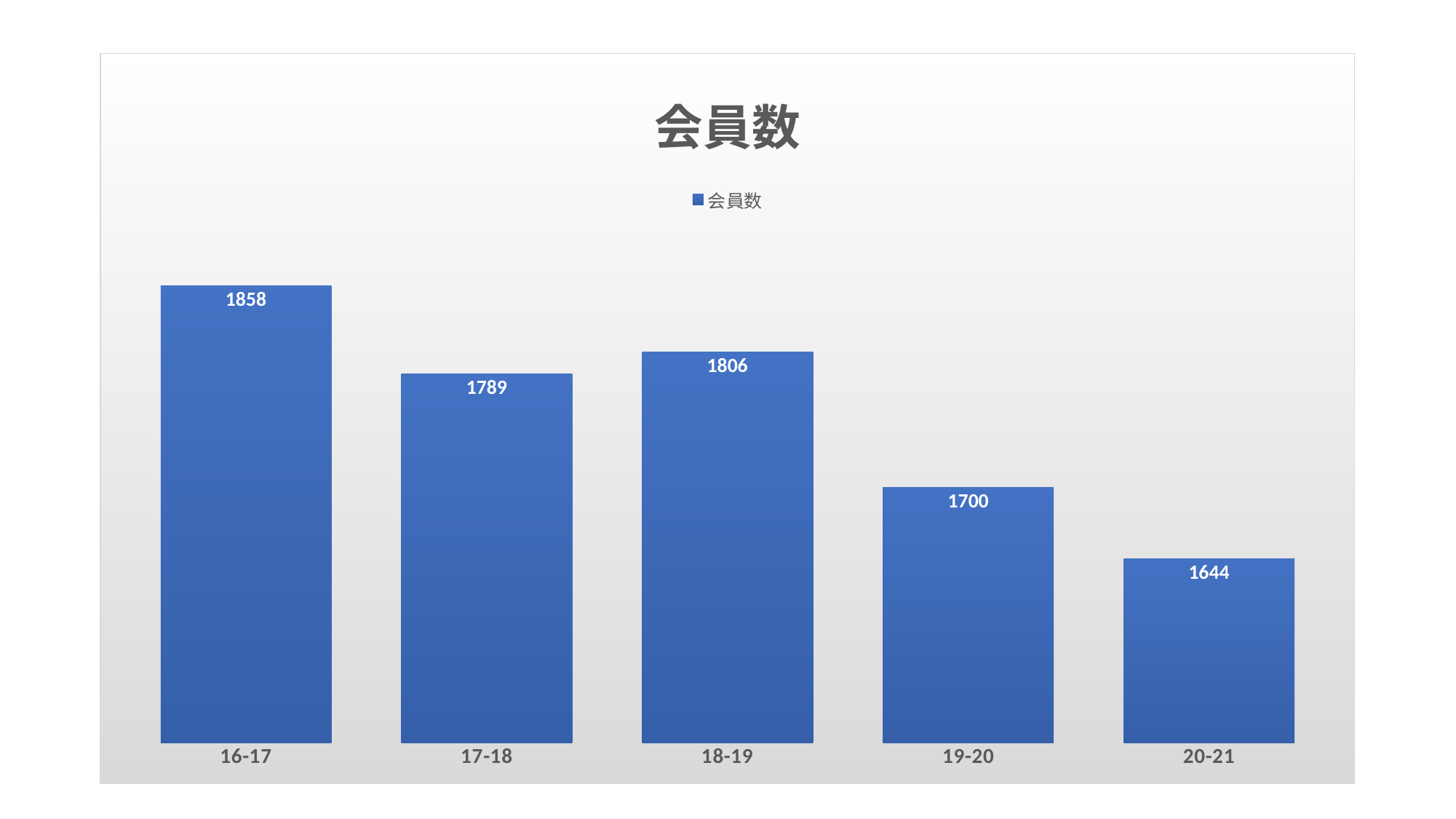
What kind of chart is this? bar chart What is the difference between the values for 18-19 and 17-18? 17 What is the value for 16-17? 1858 What is the title of the chart? 会員数 Which category has the lowest value? 20-21 Which is larger, the value for 17-18 or the value for 18-19? 18-19 How many categories are shown on the x axis? 5 Which category has the highest value? 16-17 What is the value for 19-20? 1700 What is the value for 18-19? 1806 What is the value for 20-21? 1644 What is the difference between the values for 16-17 and 20-21? 214